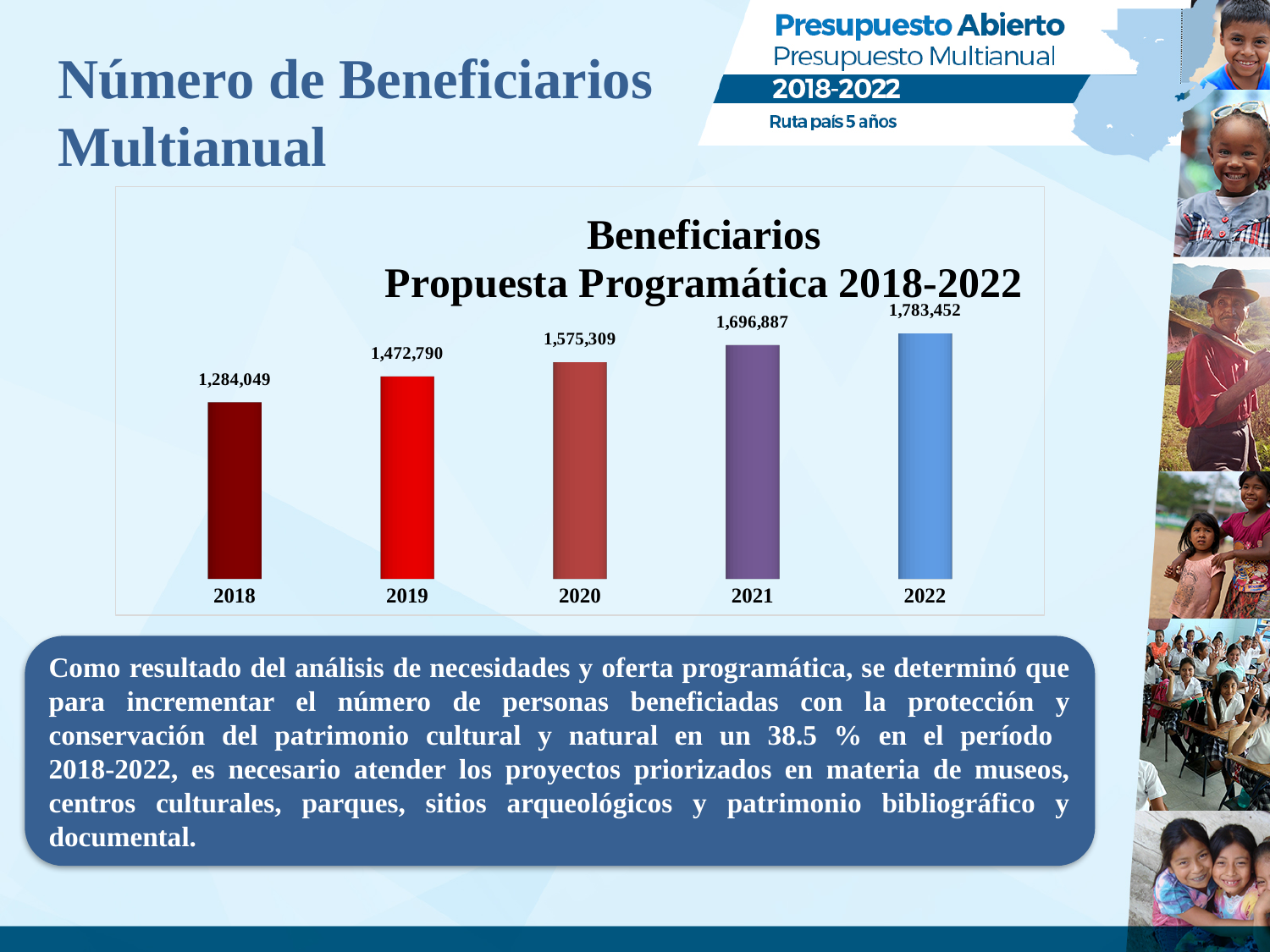
What is the difference between the values for 2019 and 2018? 188,741 What is the value for 2018 in the Beneficiarios chart? 1,284,049 What is the difference between the values for 2022 and 2018? 499,403 How many years are shown on the x axis of the chart? 5 Do the values rise or fall from 2018 to 2022? Rise What is the title of the chart? Beneficiarios Propuesta Programática 2018-2022 Which year has the highest number of beneficiarios? 2022 What kind of chart is shown on the slide? Bar chart What is the value for 2022 in the Beneficiarios chart? 1,783,452 Which is larger, the value for 2021 or the value for 2019? 2021 What is the value for 2020 in the Beneficiarios chart? 1,575,309 Which year has the lowest number of beneficiarios? 2018